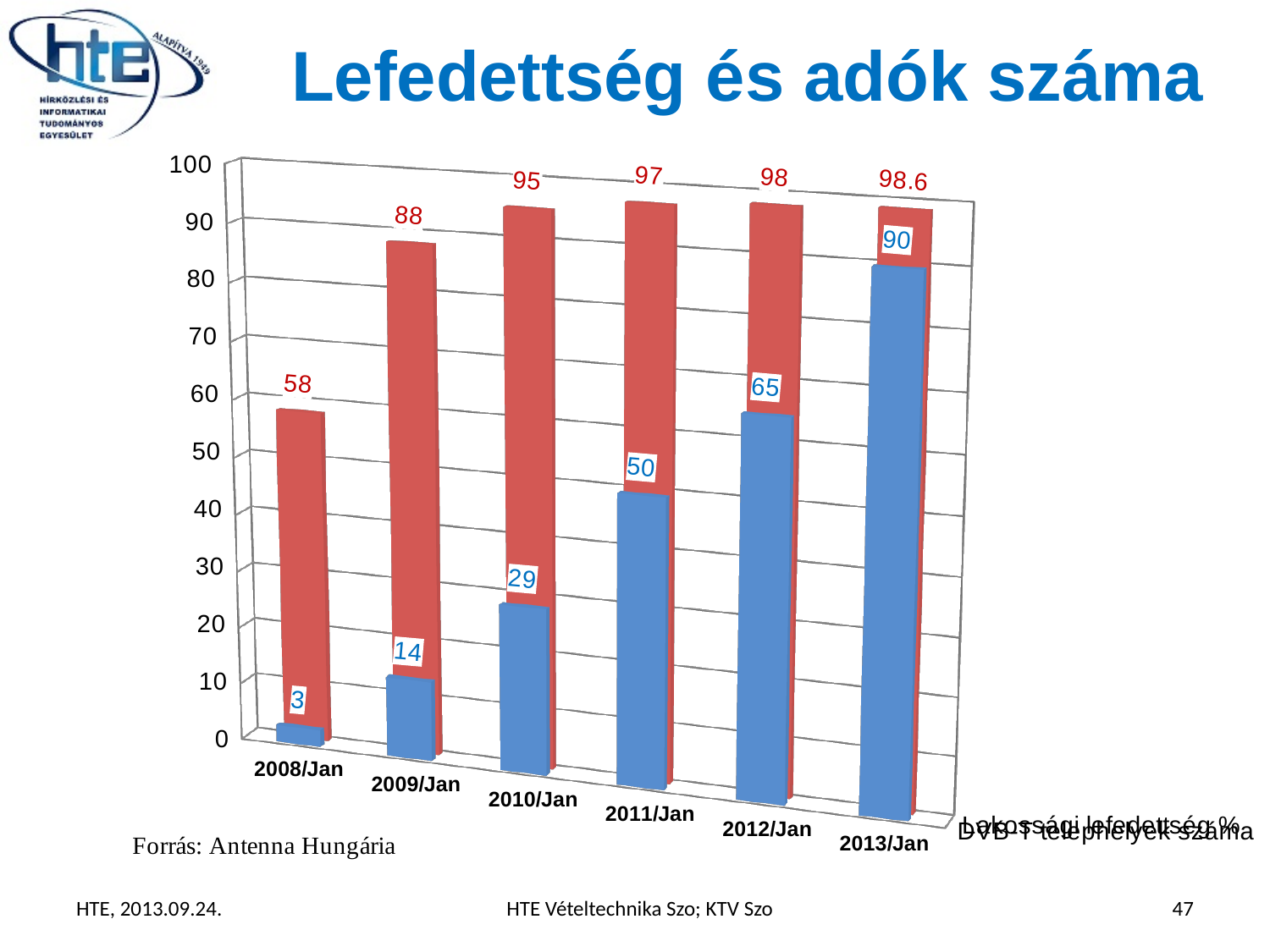
What is the difference between the red bar values for 2009/Jan and 2008/Jan? 30 What is the value of the red bar for 2008/Jan? 58 What is the value of the blue bar for 2013/Jan? 90 In which year is the red bar lowest? 2008/Jan In which year is the blue bar highest? 2013/Jan Do the blue bar values rise or fall from 2008/Jan to 2013/Jan? rise What kind of chart is shown on the slide? bar chart How many year categories are shown on the x axis? 6 What is the value of the red bar for 2013/Jan? 98.6 What is the difference between the blue bar values for 2012/Jan and 2011/Jan? 15 What is the value of the blue bar for 2010/Jan? 29 For 2011/Jan, which bar is larger, the red one or the blue one? red